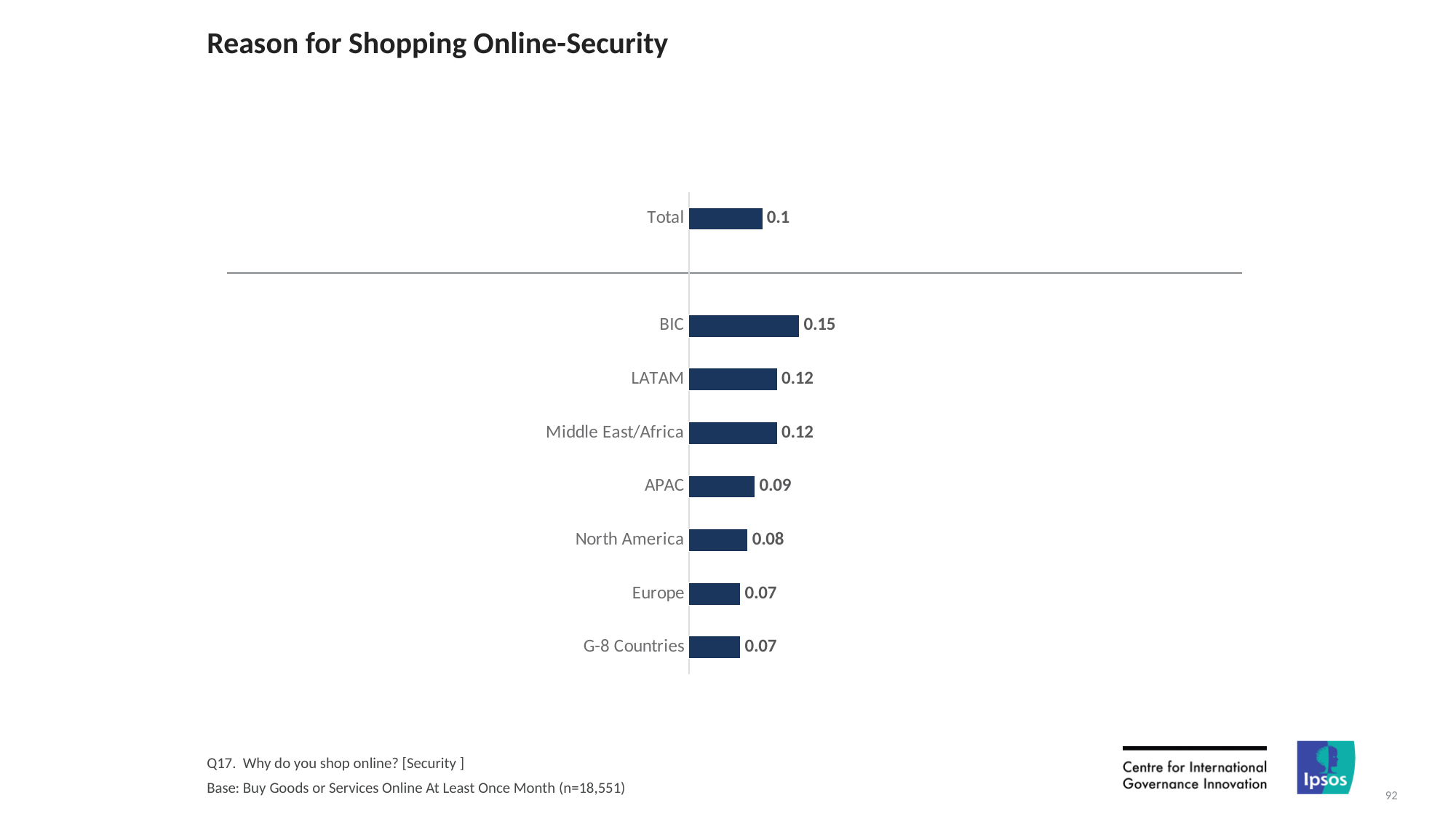
Which category has the highest value? BIC What kind of chart is shown on the slide? Bar chart What is the value for Total? 0.1 What is the value for BIC? 0.15 What is the difference between the values for BIC and Europe? 0.08 What is the title of the chart? Reason for Shopping Online-Security What is the value for North America? 0.08 Which is larger, the value for BIC or the value for Total? BIC What is the difference between the values for LATAM and North America? 0.04 How many categories are plotted on the chart? 8 Which is larger, the value for APAC or the value for Middle East/Africa? Middle East/Africa What is the value for APAC? 0.09